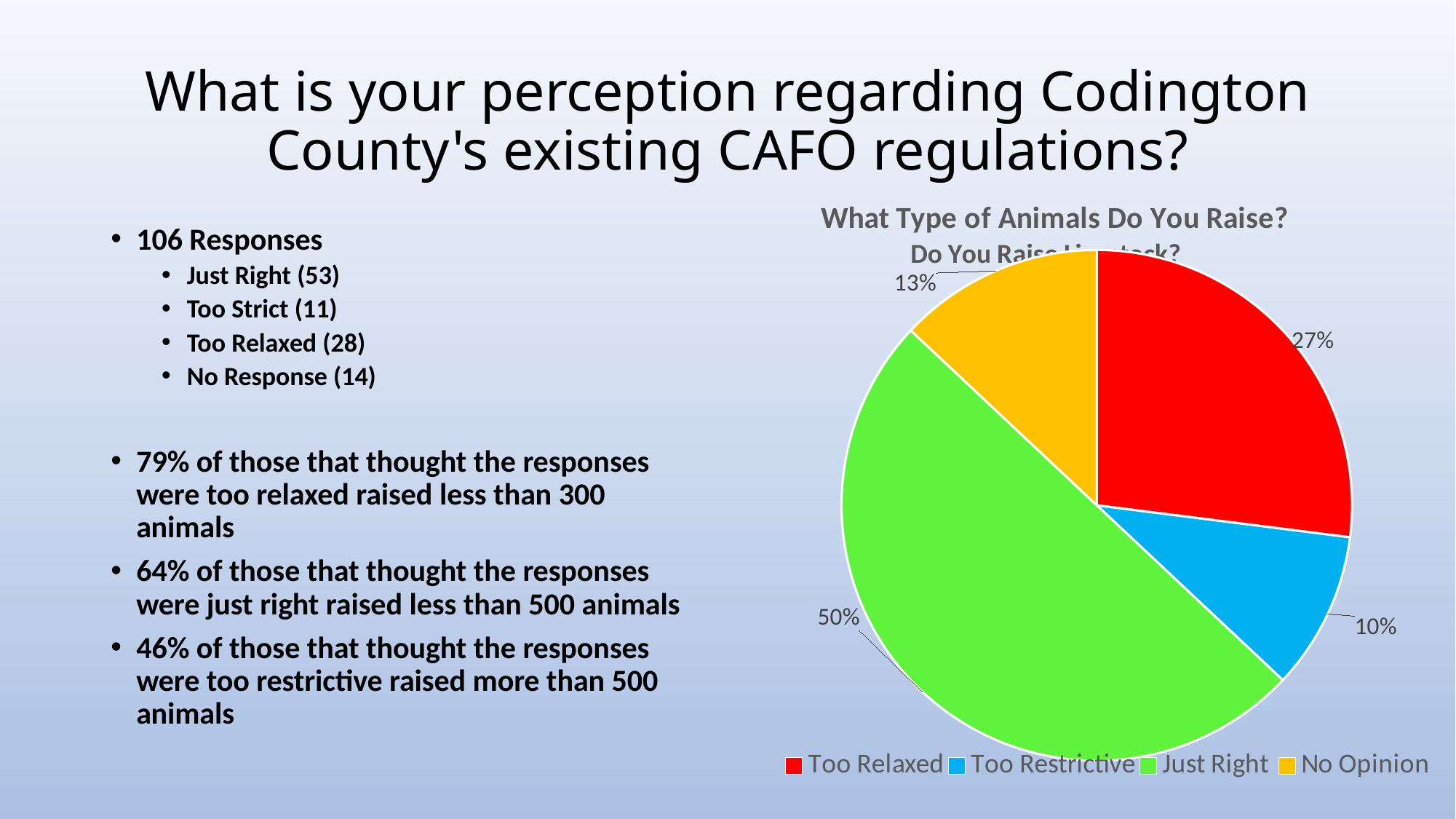
Which slice is larger, Too Relaxed or No Opinion? Too Relaxed How many entries does the legend list? 4 What share of the pie does the Just Right slice represent? 50% What share of the pie does the Too Restrictive slice represent? 10% How many slices does the pie chart have? 4 What colour is the Just Right slice in the pie chart? green Which category has the smallest slice of the pie? Too Restrictive What is the difference in percentage points between the Just Right slice and the Too Relaxed slice? 23 What share of the pie does the Too Relaxed slice represent? 27% What kind of chart is shown on the slide? pie chart Which category has the largest slice of the pie? Just Right